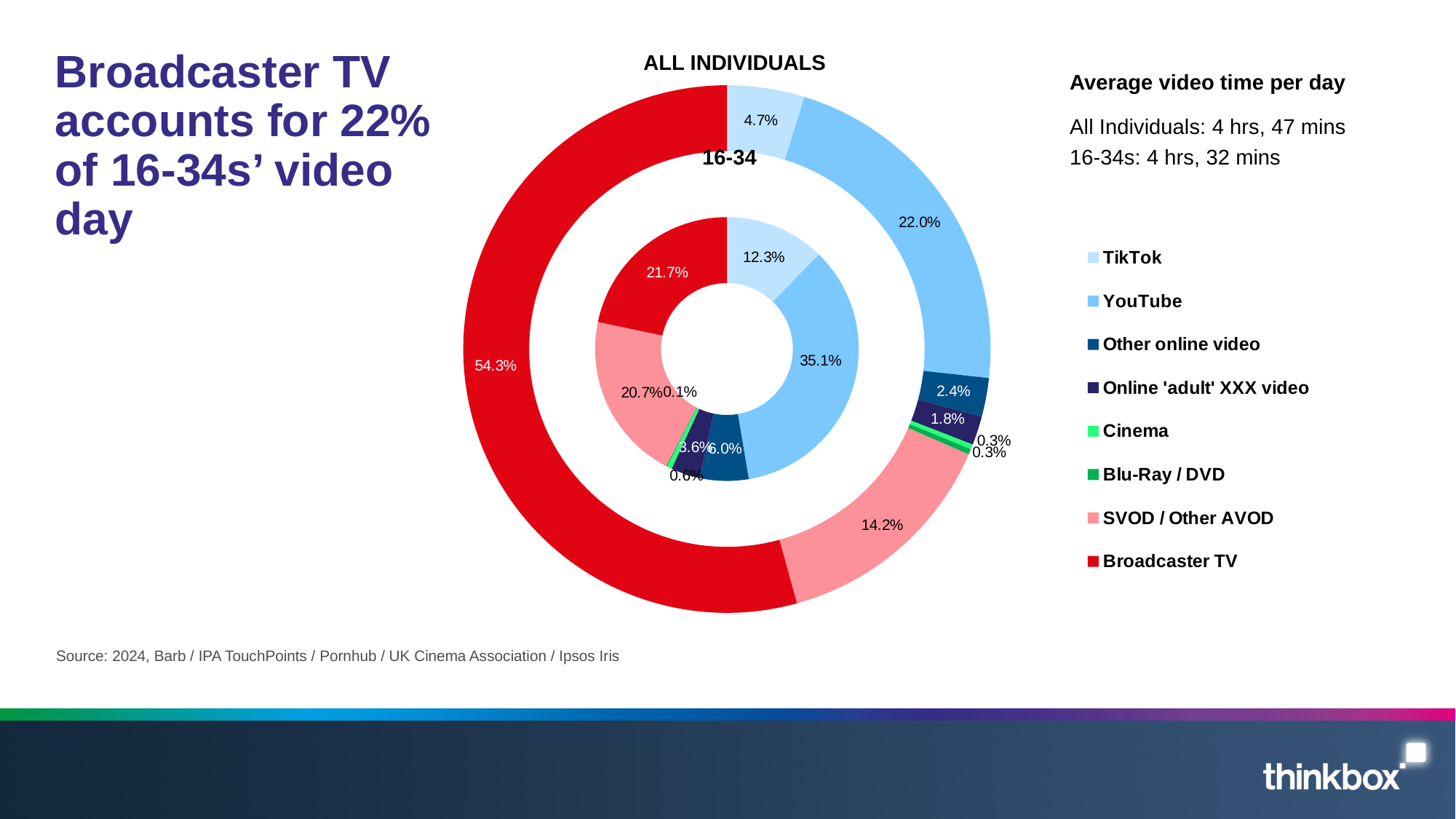
In the ALL INDIVIDUALS (outer) ring, what share does TikTok account for? 4.7% In the 16-34 (inner) ring, what share does YouTube account for? 35.1% How many categories does the legend list? 8 In the 16-34 (inner) ring, what share does Broadcaster TV account for? 21.7% Which is larger in the 16-34 (inner) ring: the TikTok share or the Other online video share? TikTok In the ALL INDIVIDUALS (outer) ring, what share does SVOD / Other AVOD account for? 14.2% What is the difference between the Broadcaster TV share for ALL INDIVIDUALS (54.3%) and for 16-34 (21.7%)? 32.6 percentage points In the ALL INDIVIDUALS (outer) ring, what share does Broadcaster TV account for? 54.3% According to the text on the slide, what is the average video time per day for 16-34s? 4 hrs, 32 mins What type of chart is shown on the slide? Doughnut chart Which category has the largest share in the ALL INDIVIDUALS (outer) ring? Broadcaster TV Which category has the largest share in the 16-34 (inner) ring? YouTube